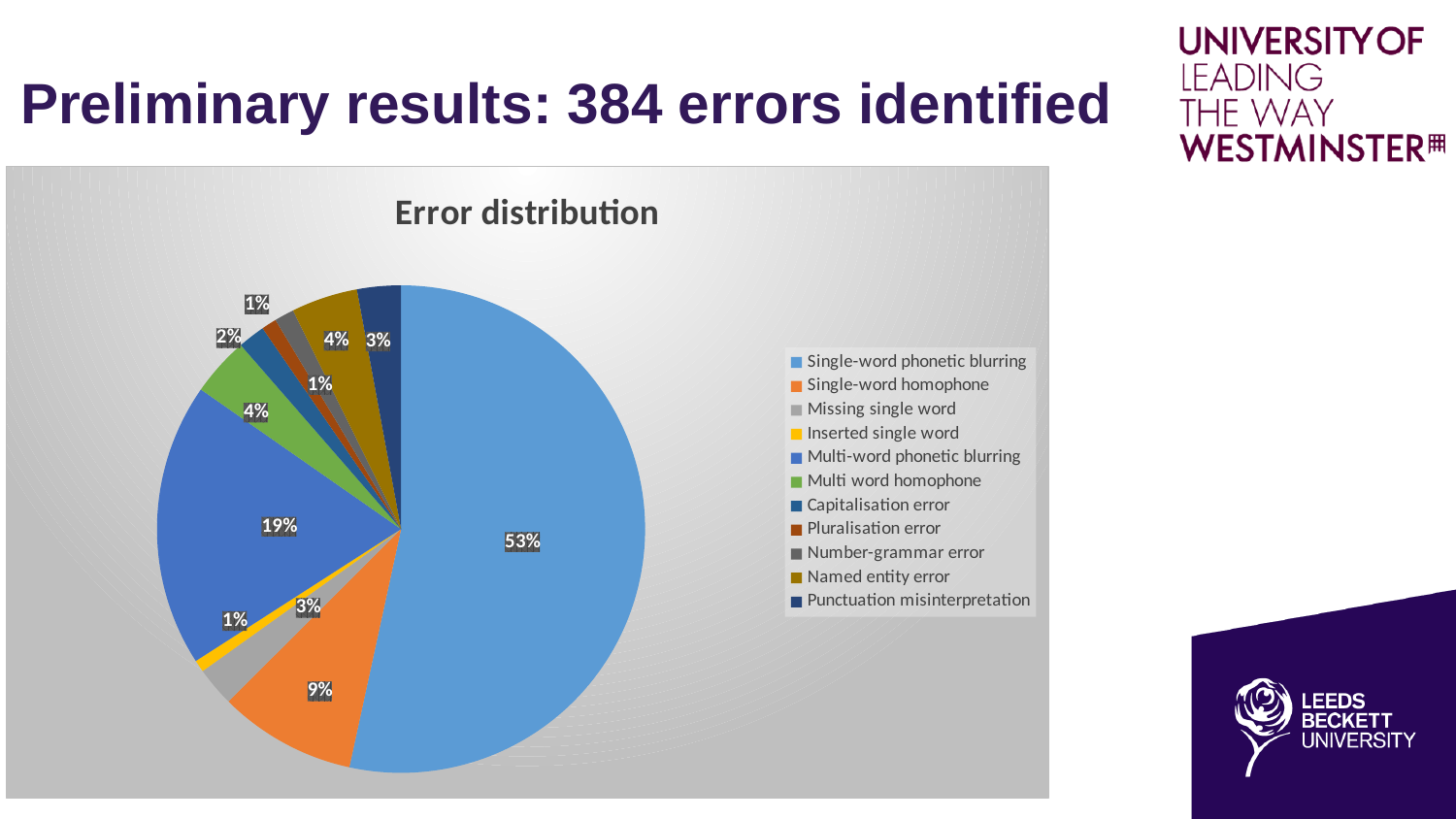
What is the difference in percentage points between Single-word phonetic blurring and Multi-word phonetic blurring? 34 What type of chart is shown on the slide? pie chart What share of errors is Single-word homophone? 9% What share of errors is Named entity error? 4% What share of errors is Multi-word phonetic blurring? 19% Is the share for Single-word phonetic blurring greater or less than 50%? greater What is the title of the chart? Error distribution How many entries does the chart legend list? 11 Which error category has the largest share of the pie? Single-word phonetic blurring Which is larger, the share for Single-word homophone or the share for Multi word homophone? Single-word homophone